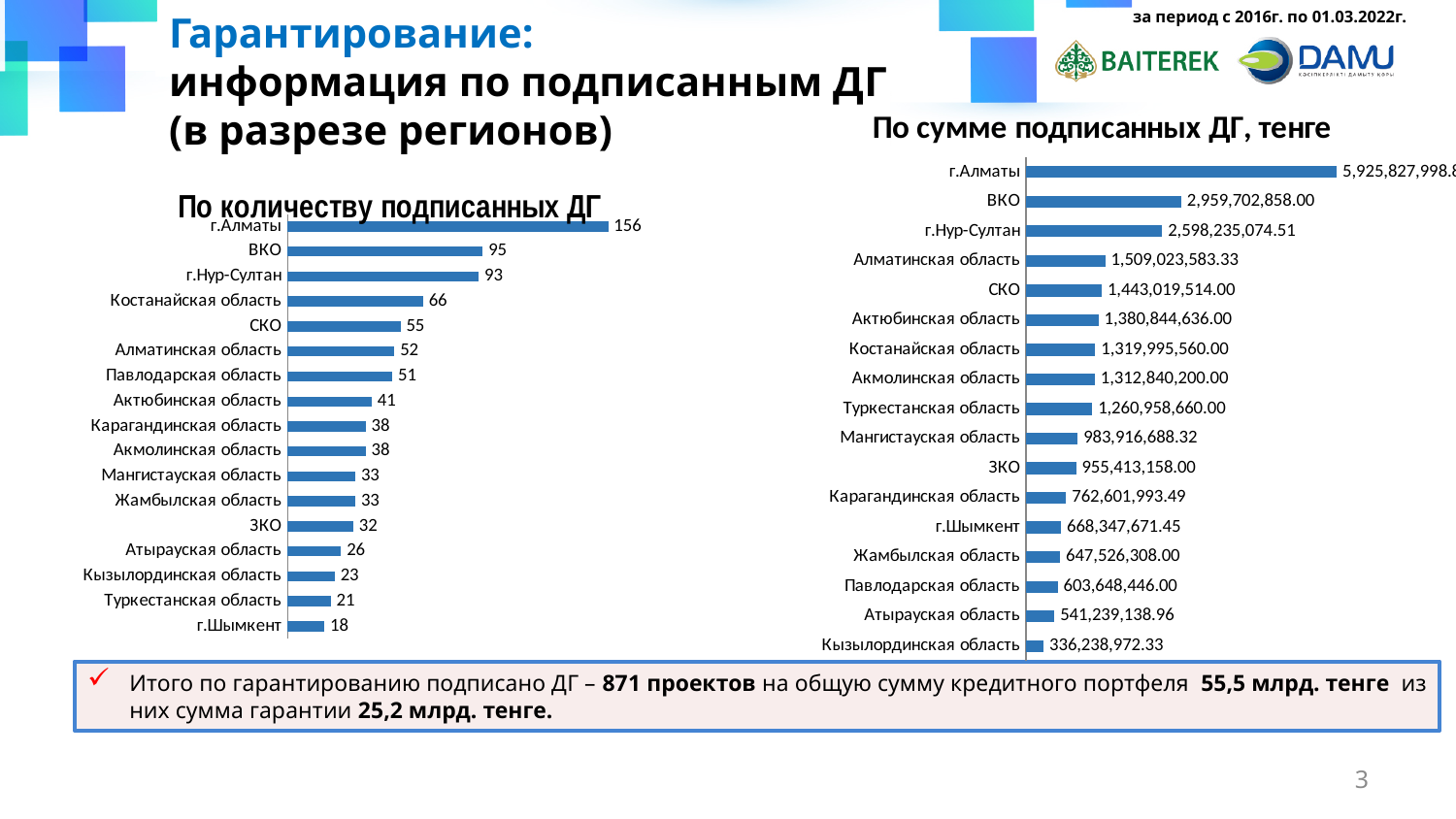
In the chart 'По сумме подписанных ДГ, тенге', what is the value for г.Шымкент? 668,347,671.45 In the chart 'По количеству подписанных ДГ', which category has the lowest value? г.Шымкент In the chart 'По количеству подписанных ДГ', what is the difference between ВКО and г.Нур-Султан? 2 What type of chart is 'По сумме подписанных ДГ, тенге'? Bar chart In the chart 'По количеству подписанных ДГ', what is the value for г.Алматы? 156 In the chart 'По сумме подписанных ДГ, тенге', which category has the highest value? г.Алматы In the chart 'По количеству подписанных ДГ', what is the value for Костанайская область? 66 In the chart 'По сумме подписанных ДГ, тенге', what is the value for ВКО? 2,959,702,858.00 In the chart 'По количеству подписанных ДГ', which is larger: Павлодарская область or Актюбинская область? Павлодарская область In the chart 'По сумме подписанных ДГ, тенге', which is larger: СКО or Актюбинская область? СКО In the chart 'По количеству подписанных ДГ', how many categories are shown? 17 In the chart 'По сумме подписанных ДГ, тенге', what is the value for Кызылординская область? 336,238,972.33